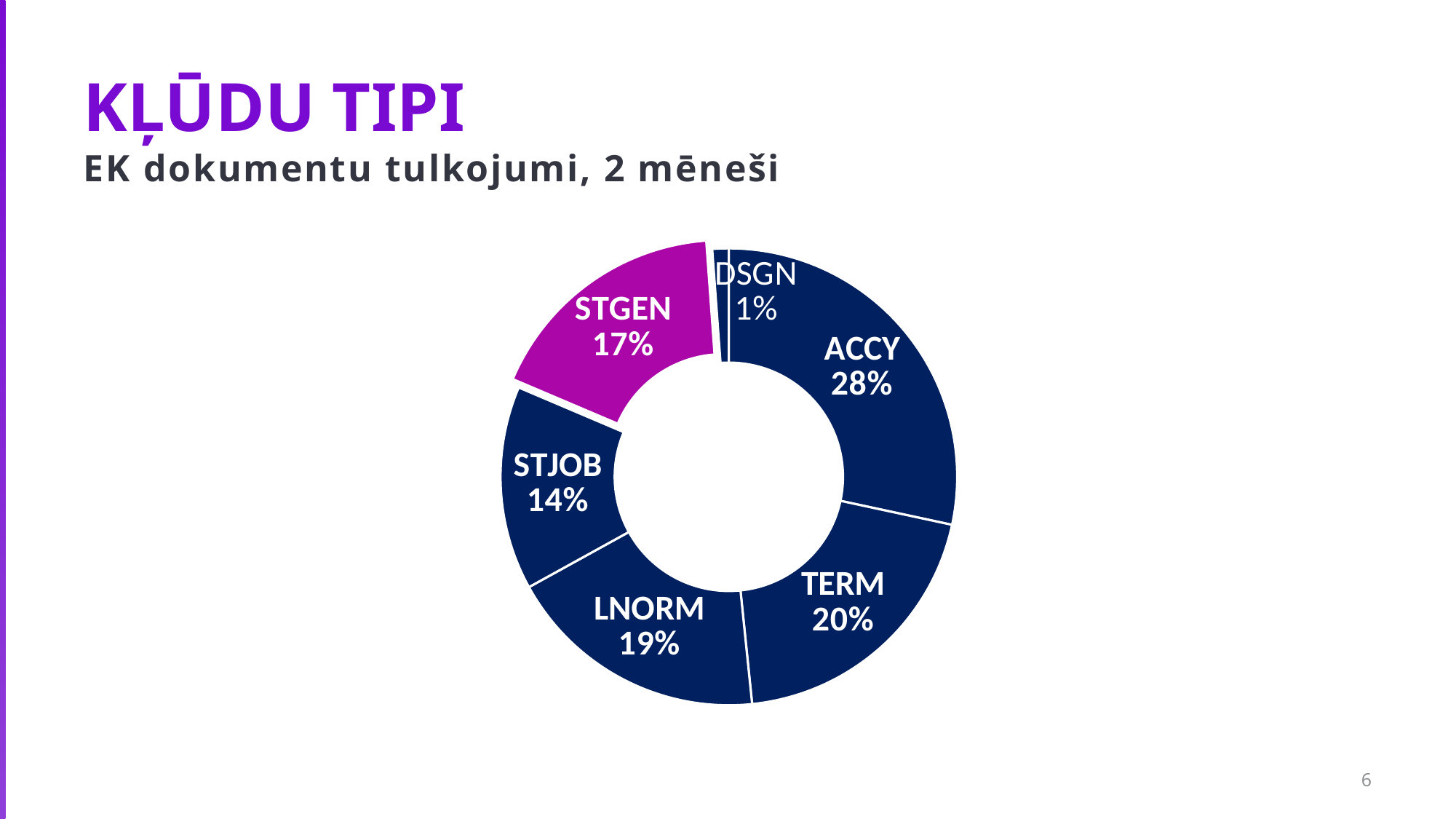
What is the value shown for TERM? 20% How many categories are shown in the chart? 6 Which category has the largest share of the chart? ACCY Which category has the smallest share of the chart? DSGN What is the difference in percentage points between ACCY and STJOB? 14 Which is larger, the share for TERM or the share for STGEN? TERM What is the value shown for STJOB? 14% Which category's slice is highlighted in a different colour (magenta) from the rest? STGEN What is the value shown for STGEN? 17% What share of the chart does ACCY account for? 28% What kind of chart is shown on the slide? Doughnut (pie) chart What is the value shown for LNORM? 19%